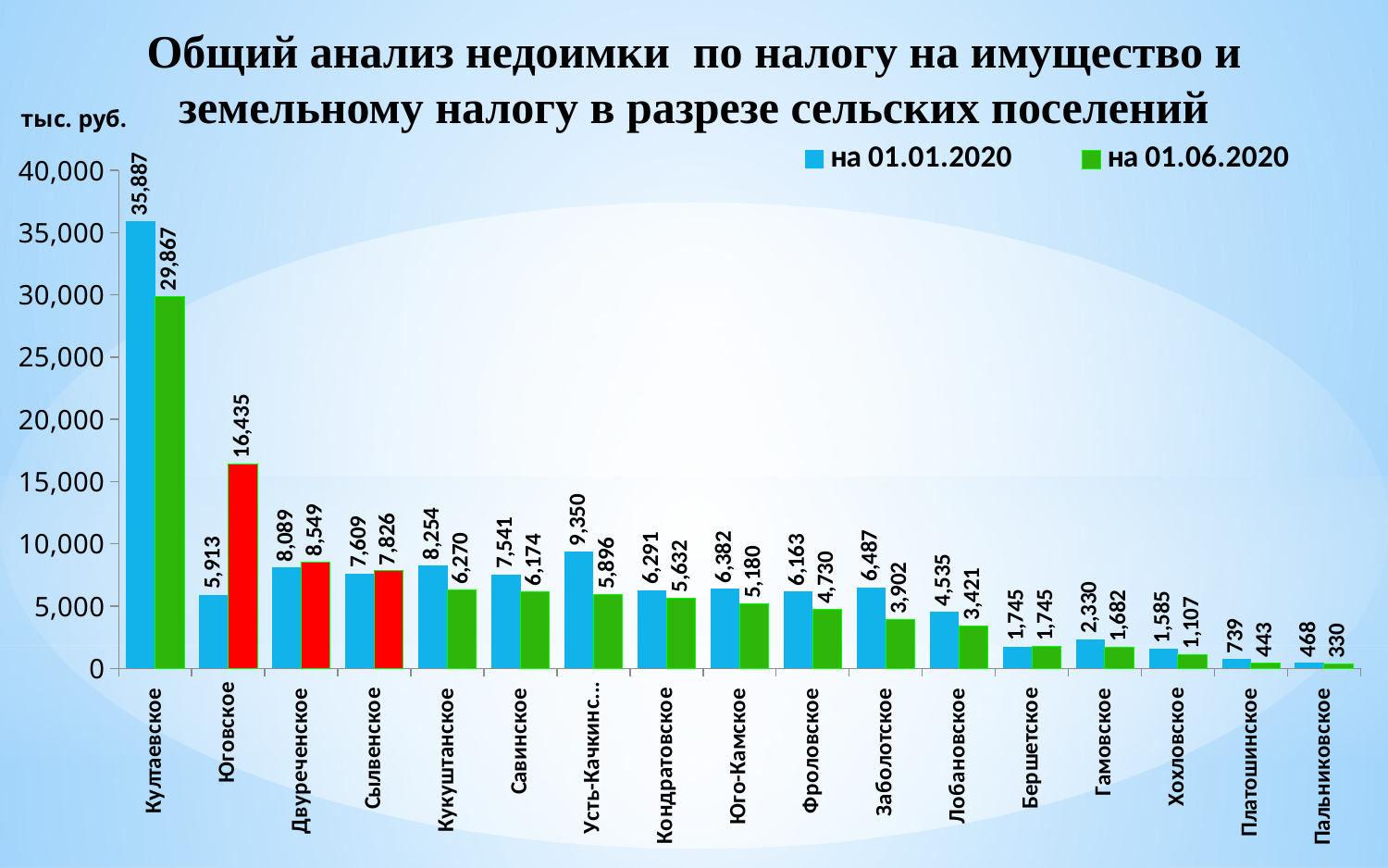
Which settlement has the highest value on 01.01.2020? Култаевское What type of chart is shown on the slide? bar chart What is the value for Заболотское on 01.06.2020? 3,902 What is the value for Юговское on 01.06.2020? 16,435 Which settlements have their 01.06.2020 bar coloured red? Юговское, Двуреченское, Сылвенское Which settlement has the lowest value on 01.06.2020? Пальниковское How many settlements are shown on the x axis? 17 By how much did the value for Юговское increase from 01.01.2020 to 01.06.2020? 10,522 Which is larger for Двуреченское: the value on 01.01.2020 or on 01.06.2020? на 01.06.2020 How many series does the legend list? 2 What is the value for Култаевское on 01.01.2020? 35,887 What is the difference between the 01.01.2020 and 01.06.2020 values for Култаевское? 6,020